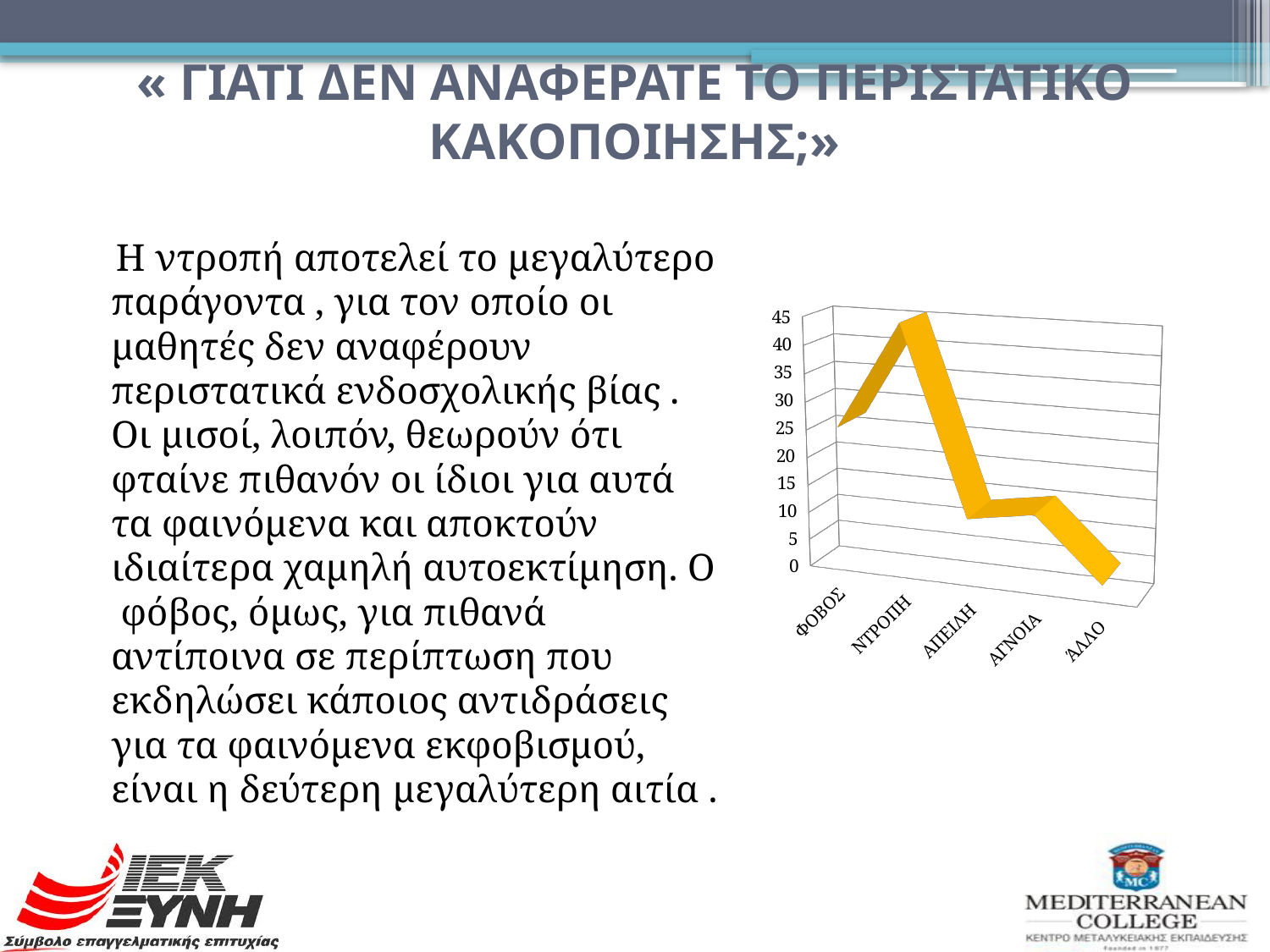
How many categories are shown on the x axis of the chart? 5 Is the value for ΆΛΛΟ greater or less than 10? less Is the value for ΝΤΡΟΠΗ greater or less than 35? greater What colour is the line in the chart? yellow/orange Does the line rise or fall from ΝΤΡΟΠΗ to ΑΠΕΙΛΗ? fall What kind of chart is shown on the slide? line chart Which category has the lowest value in the chart? ΆΛΛΟ Which has a larger value, ΦΟΒΟΣ or ΑΠΕΙΛΗ? ΦΟΒΟΣ Is the value for ΑΠΕΙΛΗ greater or less than 20? less What is the highest value shown on the vertical axis of the chart? 45 Which category has the highest value in the chart? ΝΤΡΟΠΗ